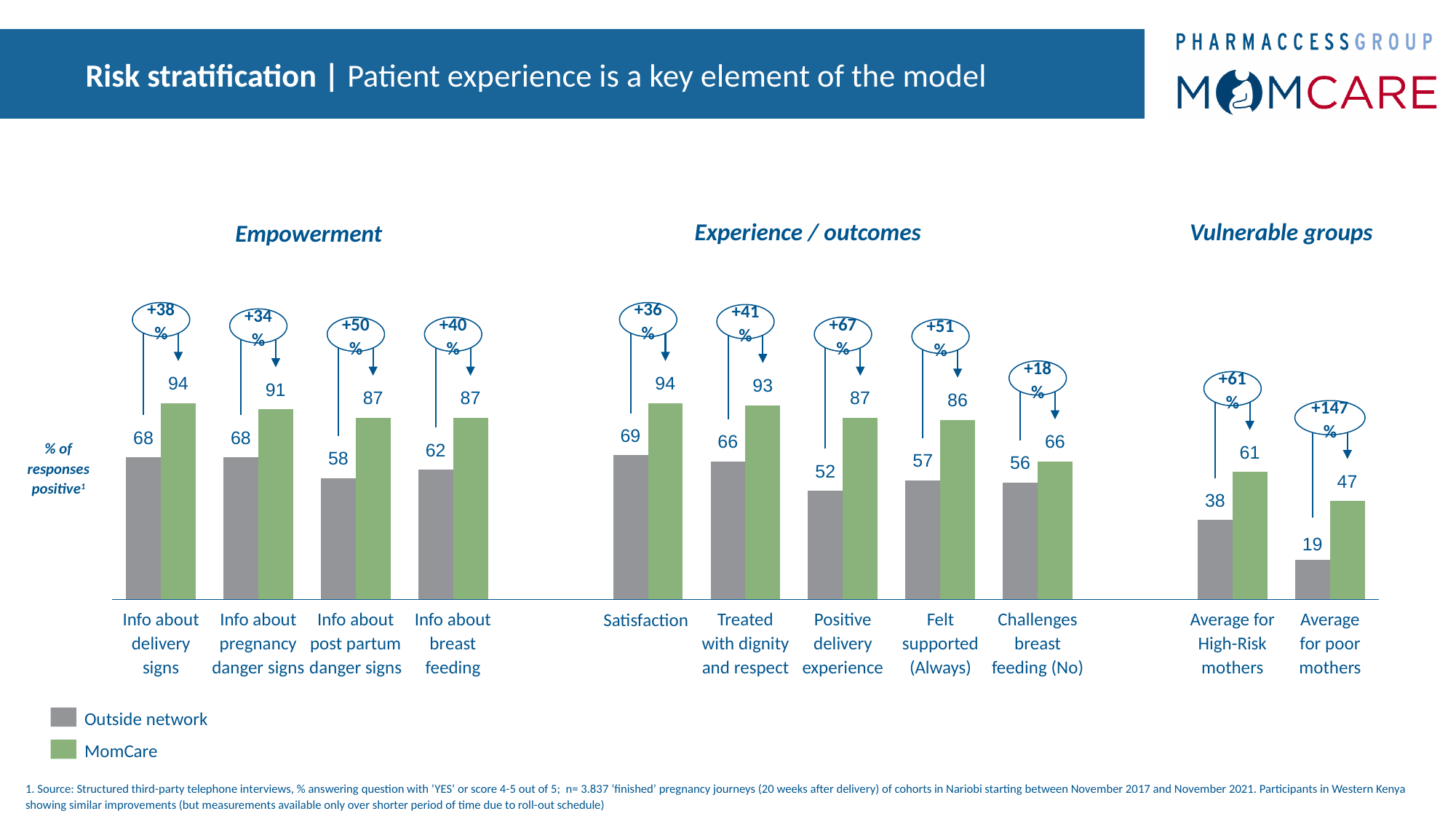
Which is larger: the MomCare value for 'Challenges breast feeding (No)' or the MomCare value for 'Average for High-Risk mothers'? Challenges breast feeding (No) What is the Outside network value for 'Positive delivery experience'? 52 What is the MomCare value for 'Info about delivery signs'? 94 What percentage improvement is shown in the circle above 'Average for poor mothers'? +147% What is the difference between the MomCare and Outside network values for 'Felt supported (Always)'? 29 What is the Outside network value for 'Average for poor mothers'? 19 Which colour represents the MomCare series? Green How many series does the legend list? 2 What kind of chart is shown on the slide? Bar chart Which category has the highest MomCare value in the Experience / outcomes section? Satisfaction Which category has the lowest Outside network value? Average for poor mothers How many categories are shown in the Empowerment section? 4